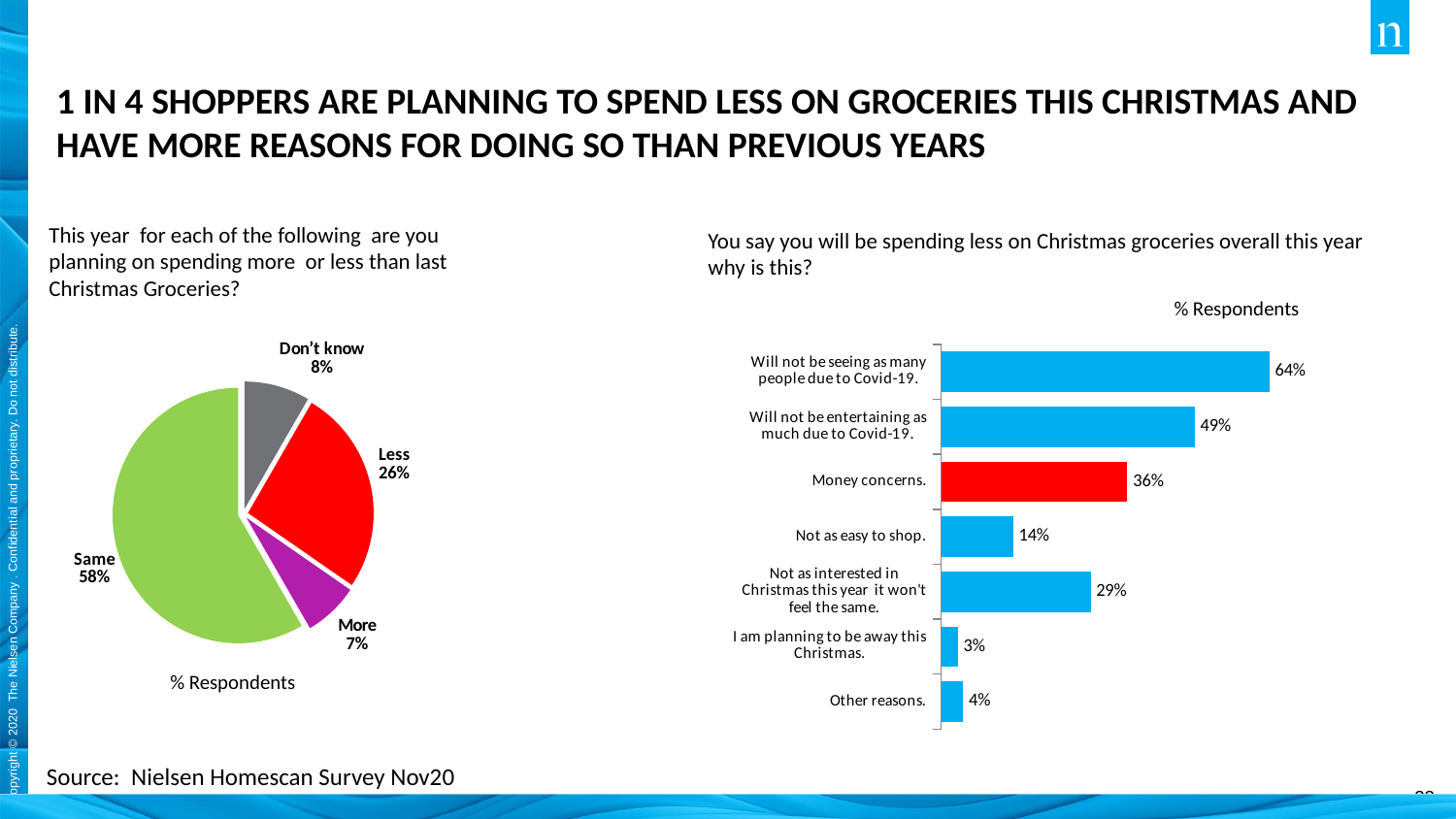
In the pie chart on the left, how many slices are there? 4 In the pie chart on the left, what percentage of respondents say they will spend less? 26% In the bar chart on the right, which reason has the lowest percentage of respondents? I am planning to be away this Christmas. In the bar chart on the right, how many reasons are listed? 7 In the pie chart on the left, which category has the smallest share? More In the bar chart on the right, which is larger: 'Not as easy to shop' or 'Not as interested in Christmas this year it won't feel the same'? Not as interested in Christmas this year it won't feel the same. In the pie chart on the left, what is the difference between the Less and More shares? 19% In the bar chart on the right, which reason has the highest percentage of respondents? Will not be seeing as many people due to Covid-19. What type of chart is shown on the right side of the slide? Bar chart In the pie chart on the left, what percentage of respondents say they will spend the same on Christmas groceries? 58% In the bar chart on the right, what percentage of respondents cite 'Money concerns'? 36% In the bar chart on the right, what is the difference between 'Will not be seeing as many people due to Covid-19' and 'Will not be entertaining as much due to Covid-19'? 15%